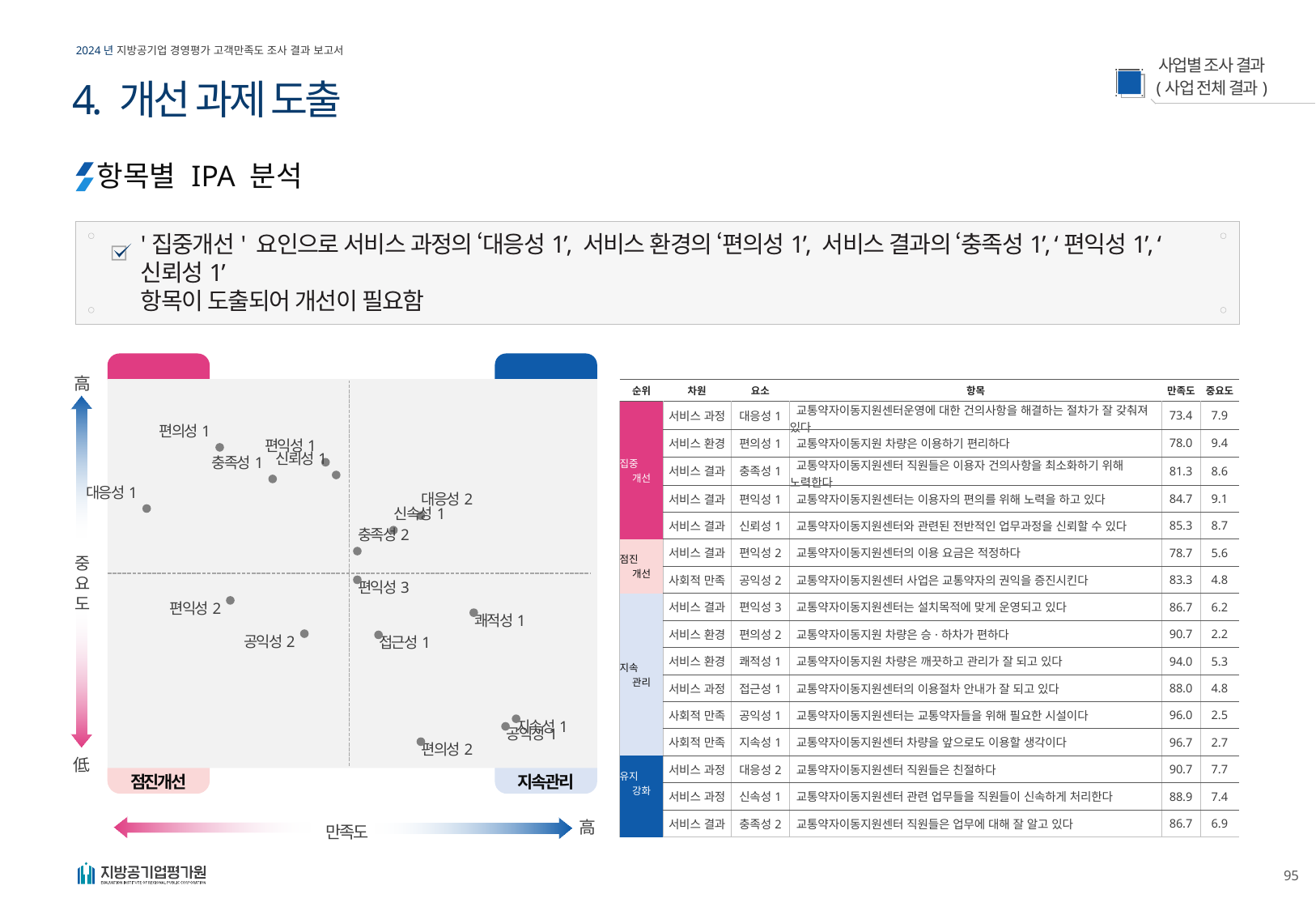
What is the difference in 만족도 between 편의성 1 and 대응성 1 in the IPA analysis? 4.6 How many data points are plotted in the IPA scatter chart? 16 In which quadrant of the IPA scatter chart does 접근성 1 fall? 지속관리 Which item has the lowest 만족도 (leftmost point) in the IPA scatter chart? 대응성 1 What is the 중요도 value for 대응성 1 in the IPA analysis? 7.9 Which item has the highest 만족도 in the IPA analysis? 지속성 1 In the IPA scatter chart, which has the higher 중요도: 편의성 1 or 편익성 2? 편의성 1 What does the horizontal axis of the IPA scatter chart represent? 만족도 Which item has the lowest 중요도 (bottommost point) in the IPA scatter chart? 편의성 2 What is the 만족도 value for 편의성 1 in the IPA analysis? 78.0 What kind of chart is shown on the left of the slide? scatter chart Which item has the highest 중요도 (topmost point) in the IPA scatter chart? 편의성 1